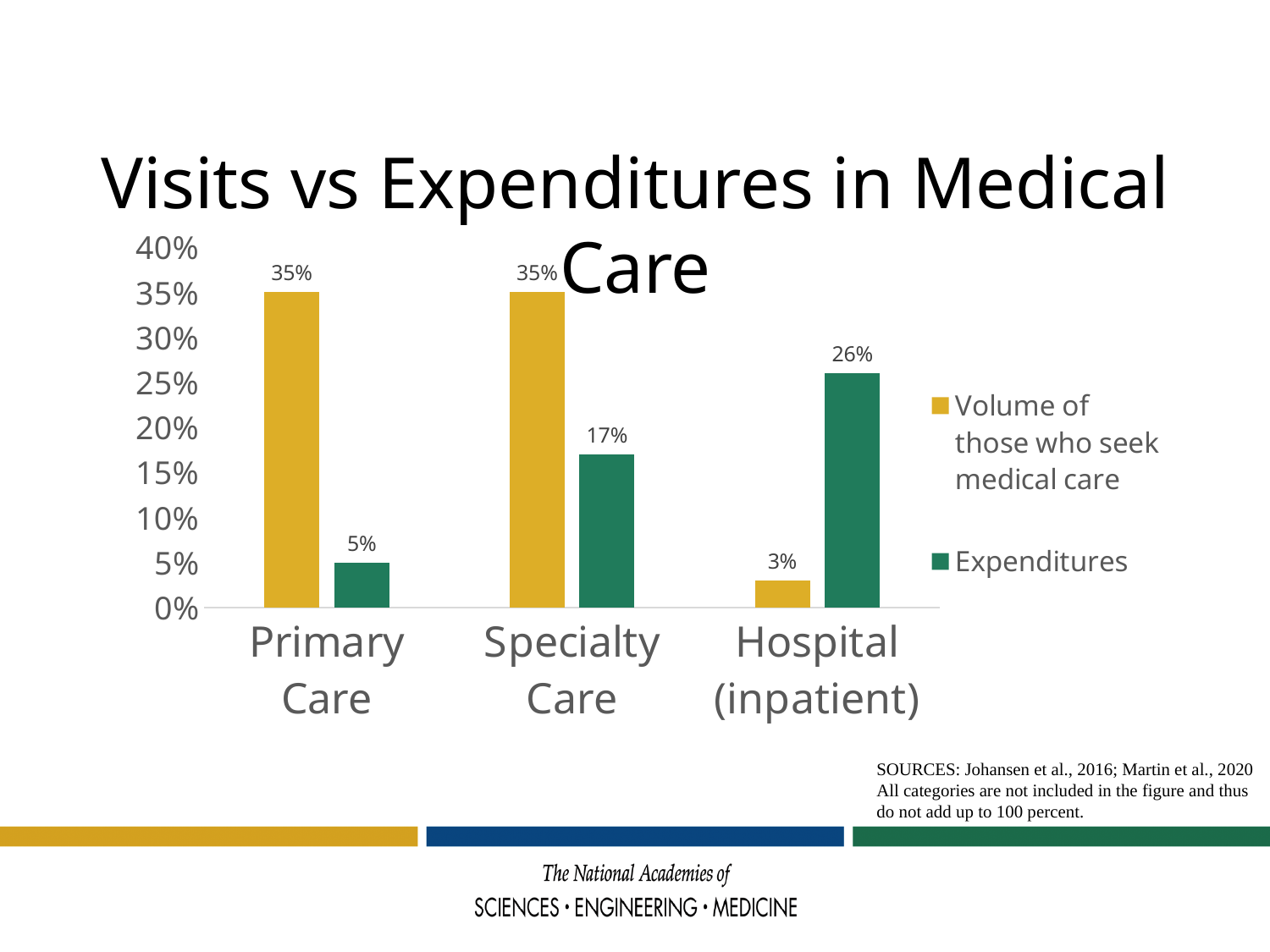
What is the difference between the Expenditures values for Hospital (inpatient) and Primary Care? 21% How many series does the legend list? 2 What kind of chart is shown on the slide? Bar chart Which category has the lowest Volume of those who seek medical care value? Hospital (inpatient) What colour are the Expenditures bars? Green What is the Volume of those who seek medical care value for Hospital (inpatient)? 3% What is the Expenditures value for Hospital (inpatient)? 26% Which category has the highest Expenditures value? Hospital (inpatient) What is the Volume of those who seek medical care value for Primary Care? 35% How many categories are shown on the x axis? 3 What is the Expenditures value for Specialty Care? 17% Which is larger for Specialty Care: Volume of those who seek medical care or Expenditures? Volume of those who seek medical care